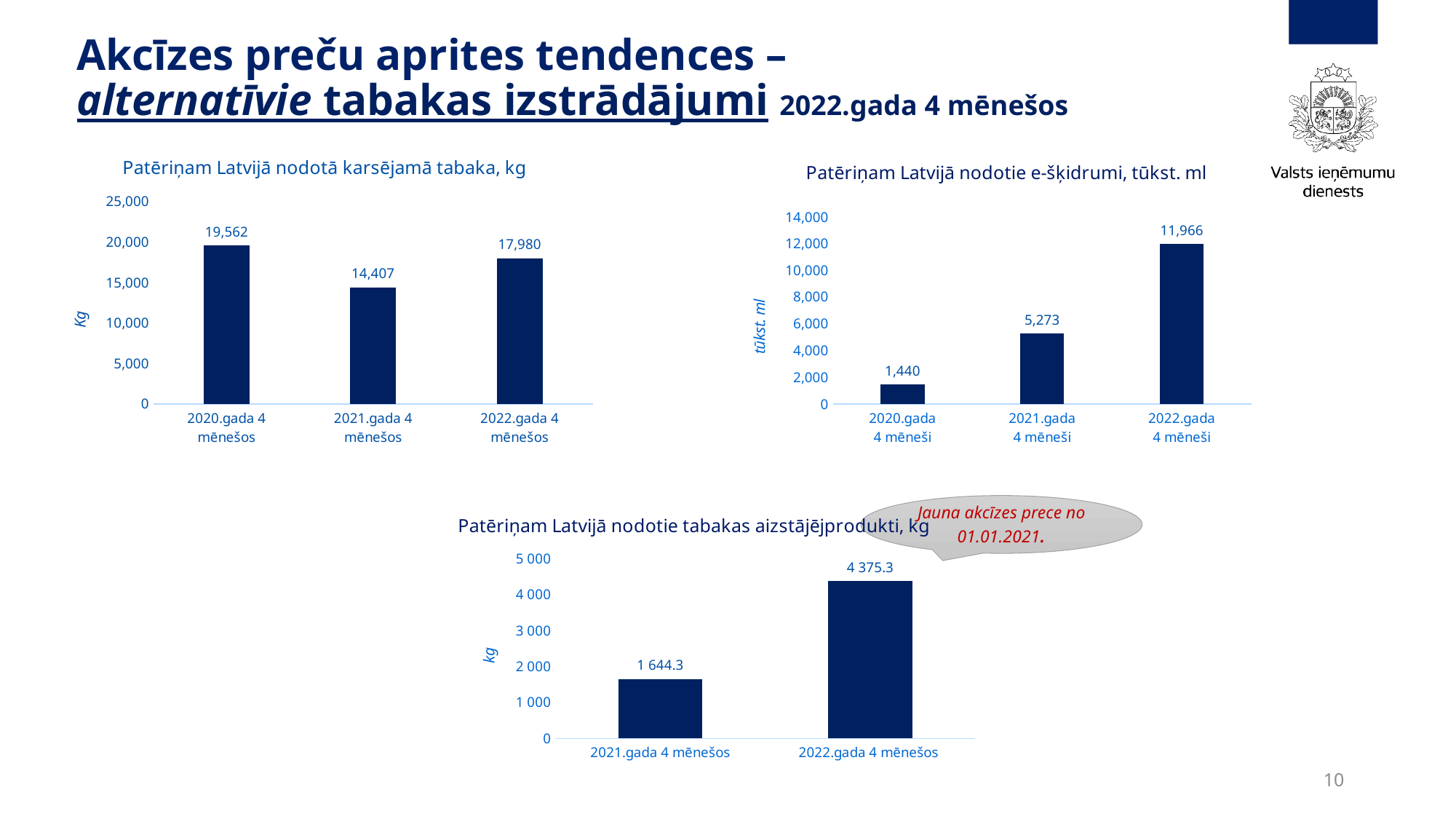
What kind of chart is 'Patēriņam Latvijā nodotie tabakas aizstājējprodukti, kg'? bar chart In the chart 'Patēriņam Latvijā nodotā karsējamā tabaka, kg', which period has the highest value? 2020.gada 4 mēnešos In the chart 'Patēriņam Latvijā nodotie e-šķidrumi, tūkst. ml', what is the value for 2022.gada 4 mēneši? 11,966 In the chart 'Patēriņam Latvijā nodotie tabakas aizstājējprodukti, kg', which is larger, the 2021 value or the 2022 value? 2022.gada 4 mēnešos In the chart 'Patēriņam Latvijā nodotā karsējamā tabaka, kg', what is the value for 2021.gada 4 mēnešos? 14,407 In the chart 'Patēriņam Latvijā nodotie e-šķidrumi, tūkst. ml', do the values rise or fall from 2020 to 2022? rise In the chart 'Patēriņam Latvijā nodotā karsējamā tabaka, kg', what is the difference between the 2020 and 2021 values? 5,155 In the chart 'Patēriņam Latvijā nodotā karsējamā tabaka, kg', how many bars are plotted? 3 In the chart 'Patēriņam Latvijā nodotie tabakas aizstājējprodukti, kg', what is the value for 2022.gada 4 mēnešos? 4 375.3 In the chart 'Patēriņam Latvijā nodotie e-šķidrumi, tūkst. ml', what is the difference between the 2022 and 2021 values? 6,693 In the chart 'Patēriņam Latvijā nodotie e-šķidrumi, tūkst. ml', which period has the lowest value? 2020.gada 4 mēneši What is the y-axis label of the chart 'Patēriņam Latvijā nodotie e-šķidrumi, tūkst. ml'? tūkst. ml